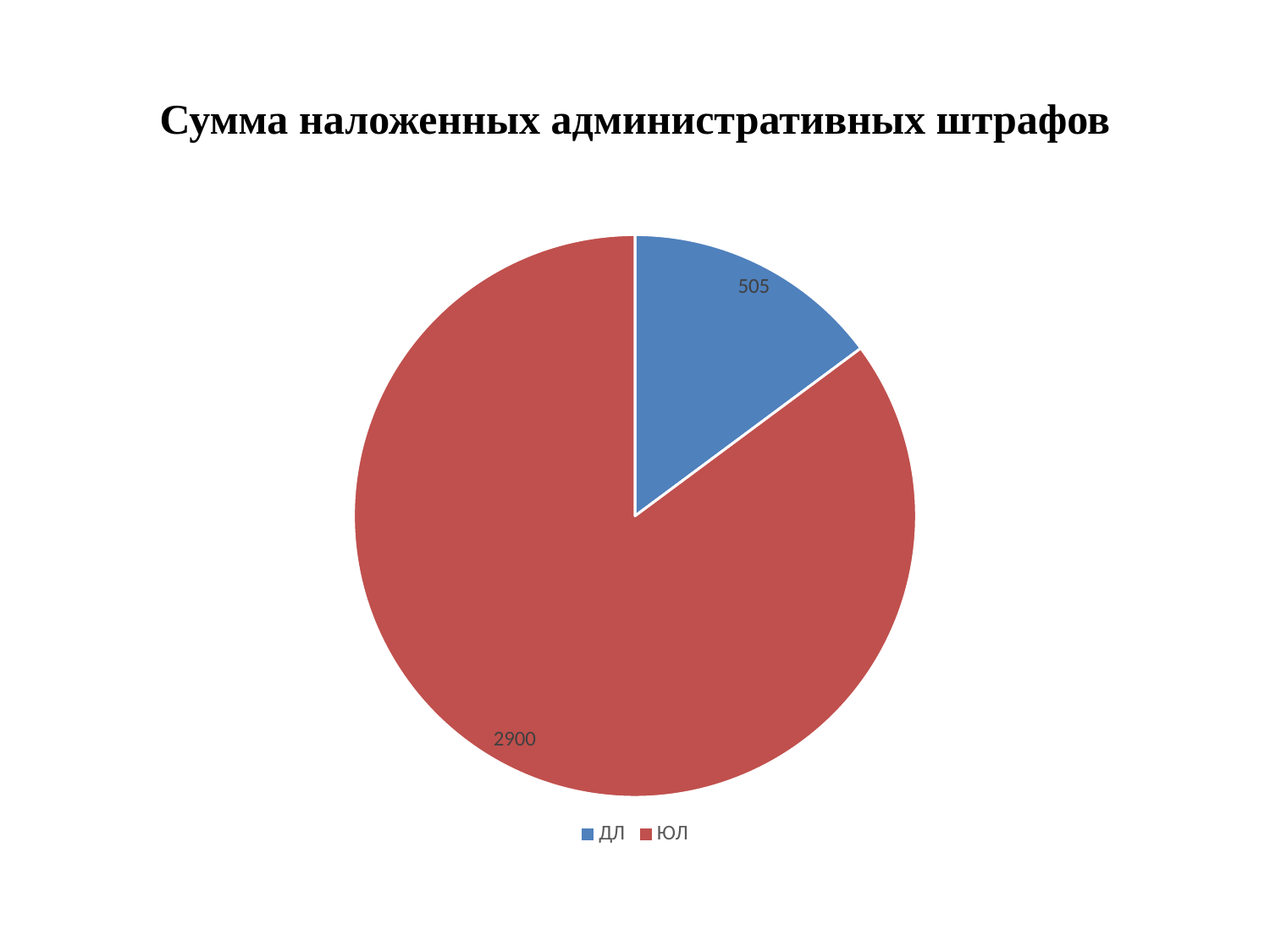
What is the value for ЮЛ? 2900 Which is larger, the value for ДЛ or the value for ЮЛ? ЮЛ To the nearest whole percent, what share of the pie does ДЛ represent? 15% What is the title of the chart? Сумма наложенных административных штрафов What is the total of all slices in the pie chart? 3405 Which category has the largest slice of the pie? ЮЛ Which category has the smallest slice of the pie? ДЛ What type of chart is shown on the slide? pie chart What is the difference between the values for ЮЛ and ДЛ? 2395 How many entries does the legend list? 2 How many slices does the pie chart have? 2 What is the value for ДЛ? 505